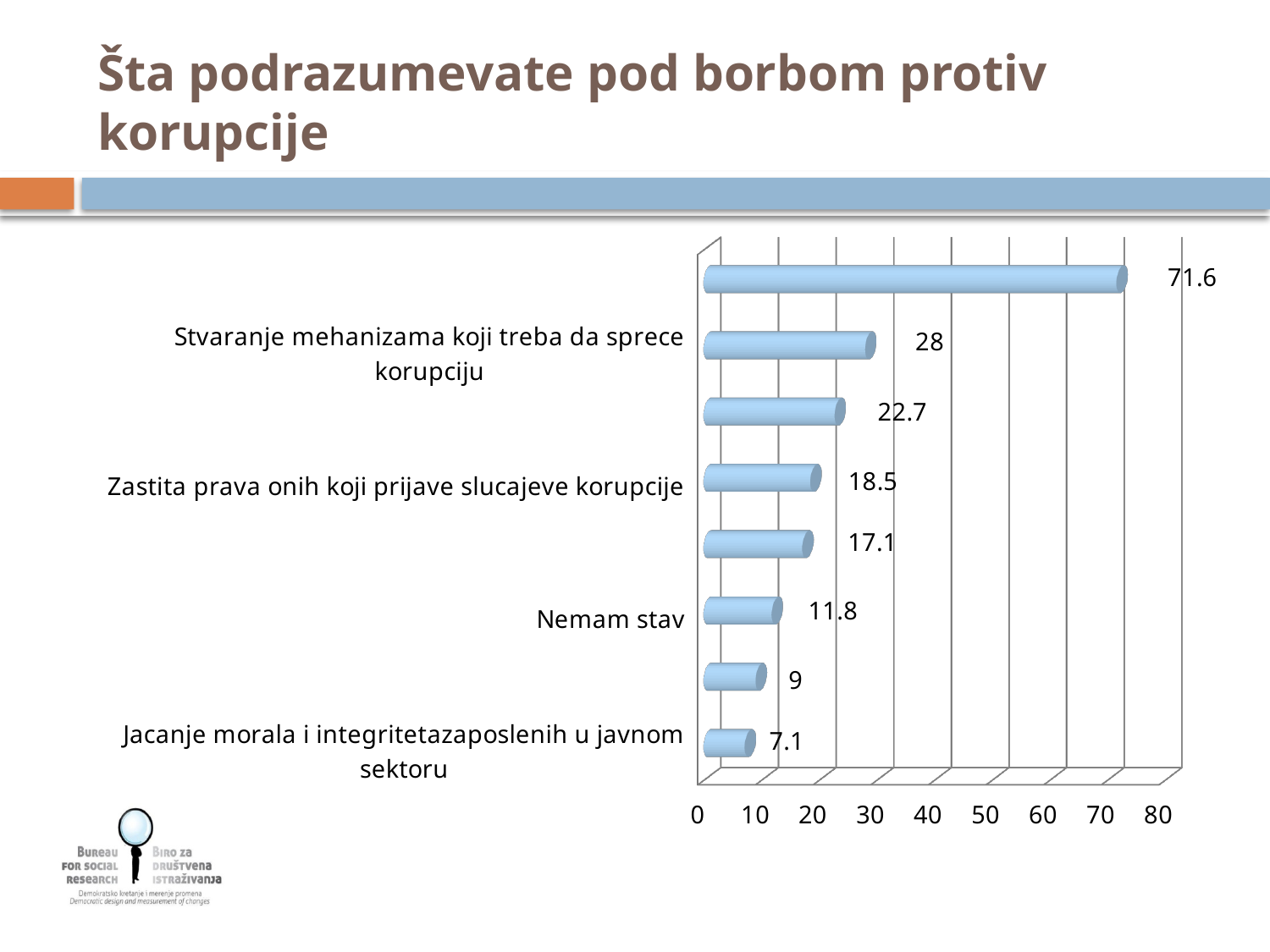
Which is larger: the value for "Nemam stav" or the value for "Jacanje morala i integritetazaposlenih u javnom sektoru"? Nemam stav What is the value for "Stvaranje mehanizama koji treba da sprece korupciju"? 28 What is the title of the slide? Šta podrazumevate pod borbom protiv korupcije What is the difference between the values for "Stvaranje mehanizama koji treba da sprece korupciju" and "Zastita prava onih koji prijave slucajeve korupcije"? 9.5 What is the value for "Zastita prava onih koji prijave slucajeve korupcije"? 18.5 Which category has the lowest value? Jacanje morala i integritetazaposlenih u javnom sektoru Is the value for "Stvaranje mehanizama koji treba da sprece korupciju" greater or less than 20? greater What kind of chart is shown on the slide? bar chart How many bars does the chart contain? 8 What is the largest value shown in the chart? 71.6 What is the value for "Nemam stav"? 11.8 What is the value for "Jacanje morala i integritetazaposlenih u javnom sektoru"? 7.1